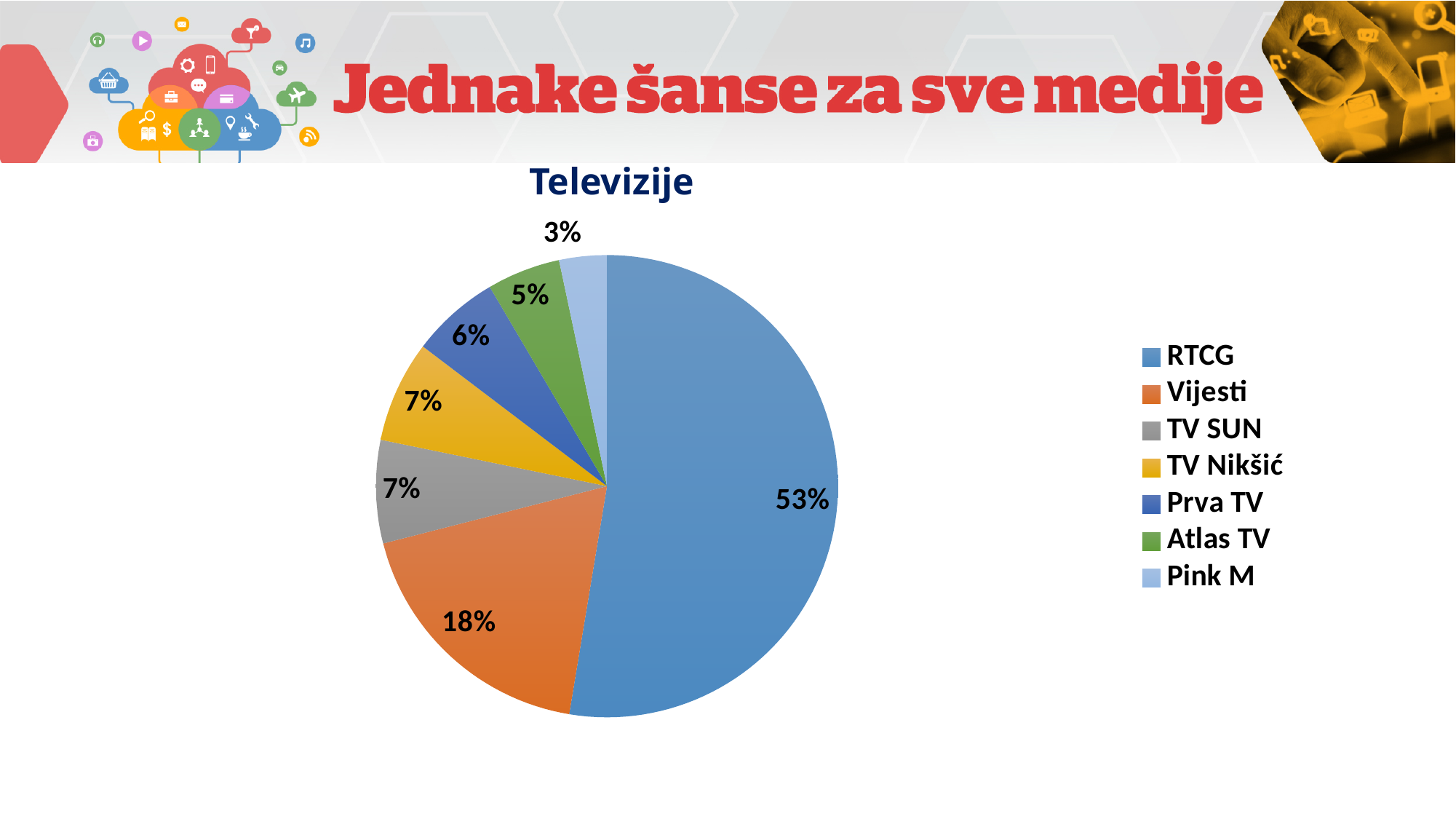
Which category has the smallest slice of the pie? Pink M What share of the pie does Prva TV have? 6% How many categories does the legend list? 7 Which is larger, the share for Vijesti or the share for TV Nikšić? Vijesti What is the difference in percentage points between RTCG and Vijesti? 35 Which category has the largest slice of the pie? RTCG What type of chart is shown on the slide? pie chart What share of the pie does Vijesti have? 18% What is the title of the chart? Televizije What share of the pie does RTCG have? 53% What share of the pie does Atlas TV have? 5% What share of the pie does Pink M have? 3%